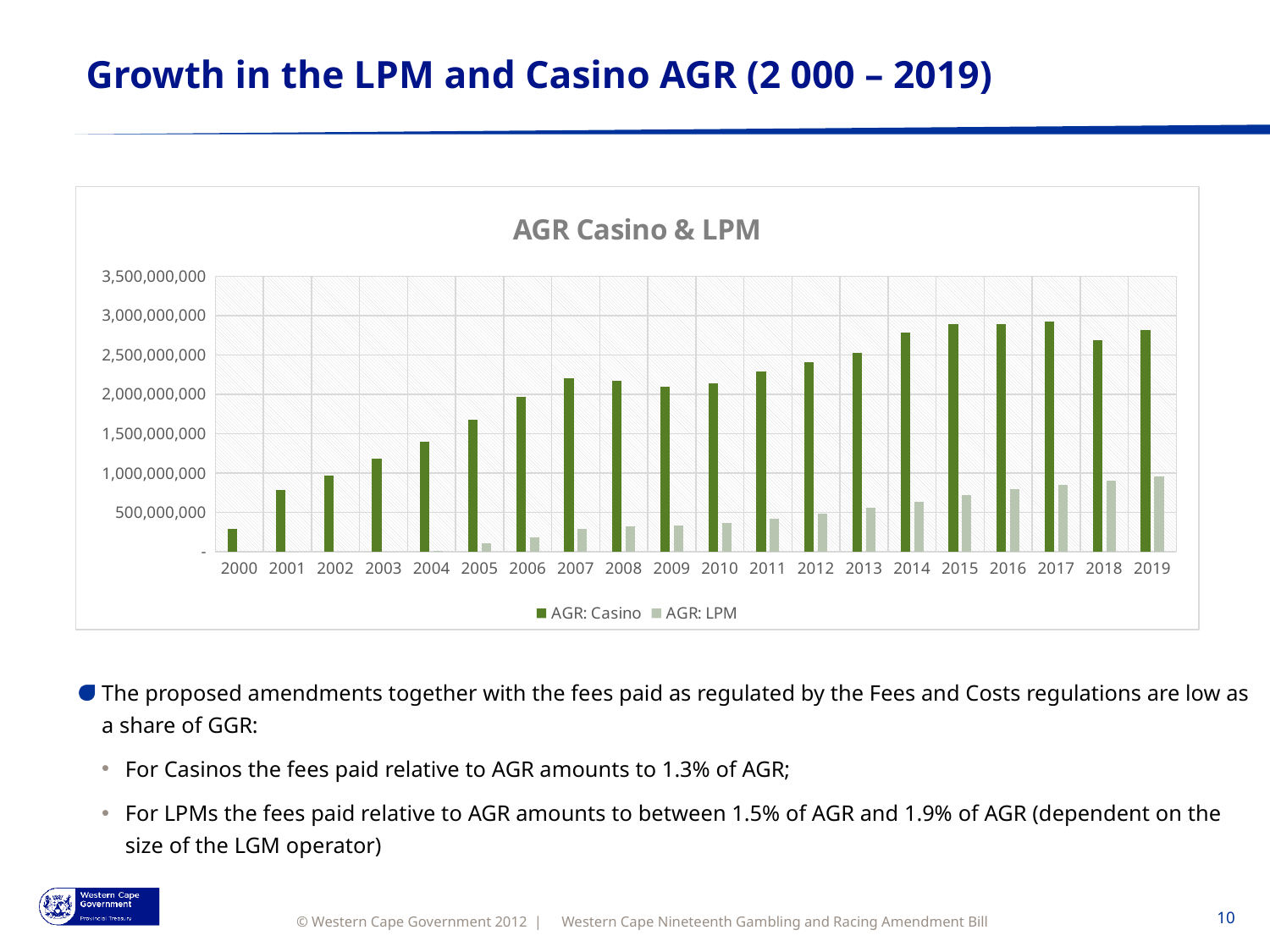
Is the AGR: Casino value for 2007 greater or less than 2,000,000,000? greater How many series does the legend of the chart list? 2 In 2019, which is larger: AGR: Casino or AGR: LPM? AGR: Casino What kind of chart is shown on the slide? bar chart How many years are shown along the x axis of the chart? 20 Is the AGR: LPM value for 2019 greater or less than 1,000,000,000? less Is the AGR: Casino value for 2000 greater or less than 500,000,000? less What is the title of the chart? AGR Casino & LPM Which year has the lowest AGR: Casino value? 2000 Does the AGR: LPM value generally rise or fall from 2005 to 2019? rise Which year has the highest AGR: LPM value? 2019